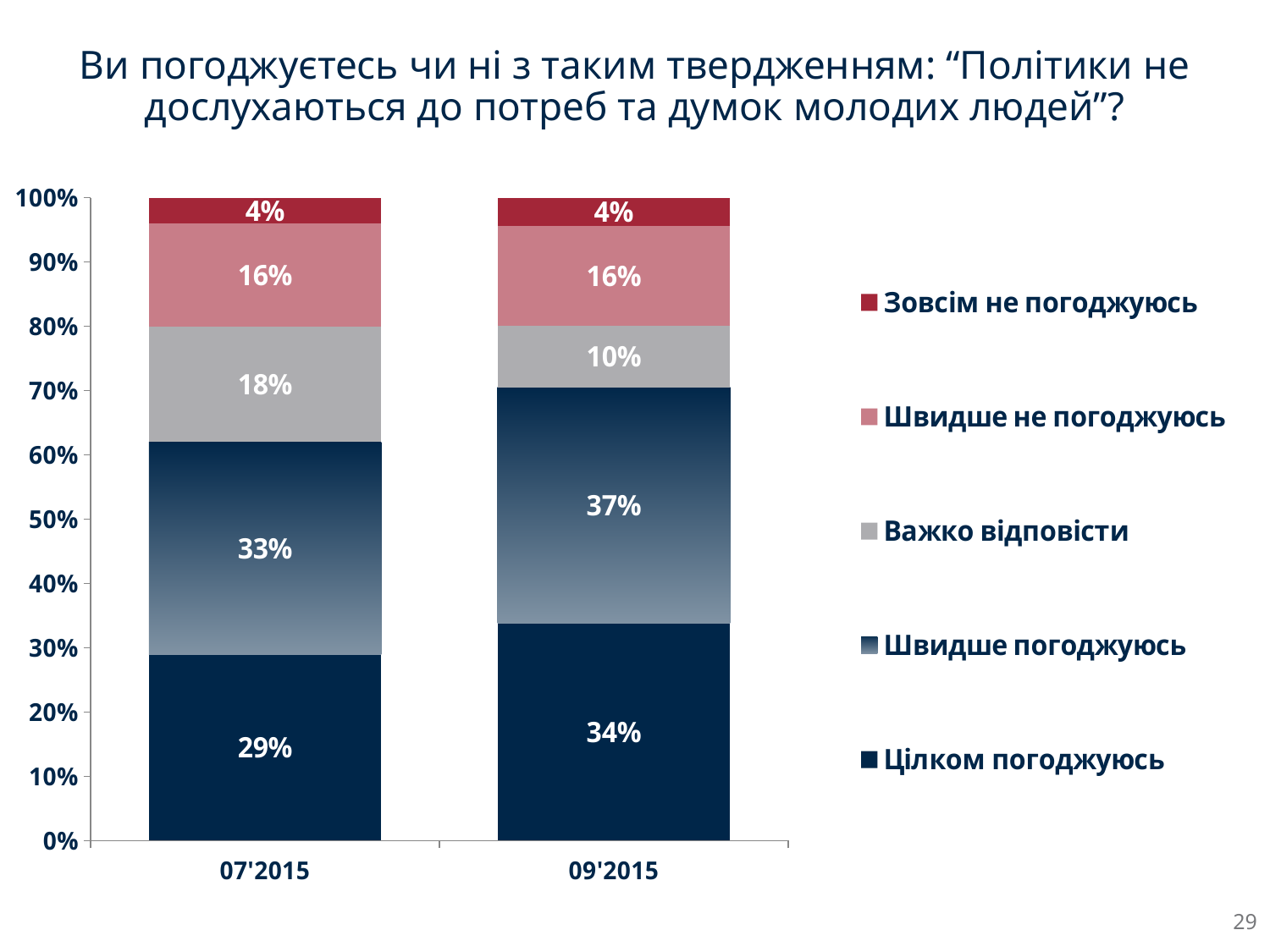
Which is larger: "Цілком погоджуюсь" in 07'2015 or in 09'2015? 09'2015 Which series has the lowest value in 09'2015? Зовсім не погоджуюсь What is the difference between the "Важко відповісти" values for 07'2015 and 09'2015? 8% How many categories are shown on the x axis? 2 What is the value for "Швидше не погоджуюсь" in 07'2015? 16% Does the value for "Цілком погоджуюсь" rise or fall from 07'2015 to 09'2015? Rise What is the value for "Швидше погоджуюсь" in 09'2015? 37% What is the value for "Цілком погоджуюсь" in 07'2015? 29% Which series has the highest value in 09'2015? Швидше погоджуюсь What kind of chart is shown on the slide? Stacked bar chart How many series does the legend list? 5 What is the value for "Важко відповісти" in 09'2015? 10%